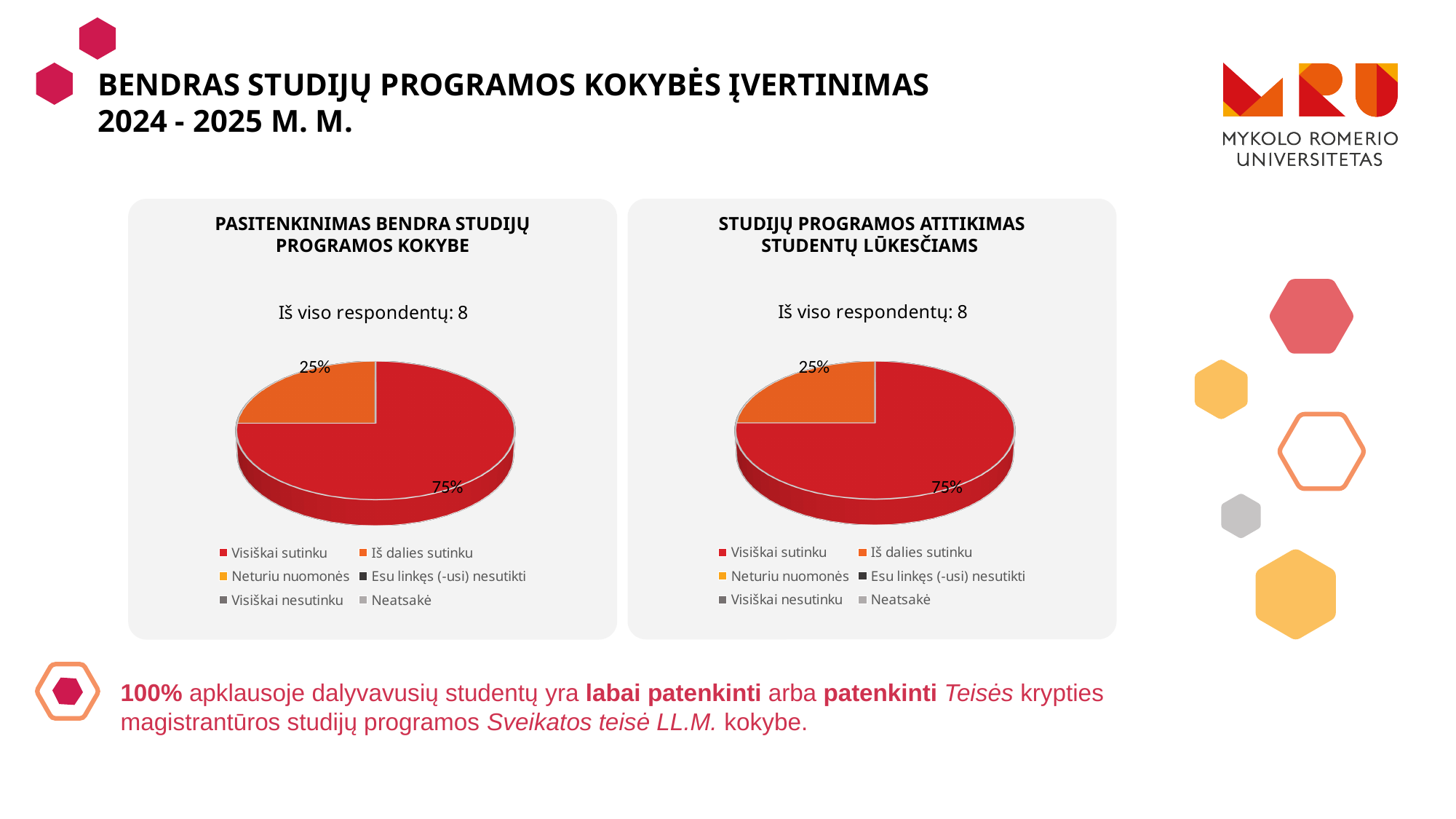
In the right chart 'Studijų programos atitikimas studentų lūkesčiams', what share of respondents answered 'Iš dalies sutinku'? 25% In the left chart 'Pasitenkinimas bendra studijų programos kokybe', which answer category has the largest slice? Visiškai sutinku In the left chart 'Pasitenkinimas bendra studijų programos kokybe', what share of respondents answered 'Visiškai sutinku'? 75% In the left chart 'Pasitenkinimas bendra studijų programos kokybe', what share of respondents answered 'Iš dalies sutinku'? 25% How many respondents in total are reported for the left chart 'Pasitenkinimas bendra studijų programos kokybe'? 8 In the right chart 'Studijų programos atitikimas studentų lūkesčiams', what share of respondents answered 'Visiškai sutinku'? 75% How many answer categories does the legend of the right chart 'Studijų programos atitikimas studentų lūkesčiams' list? 6 In the right chart 'Studijų programos atitikimas studentų lūkesčiams', which is larger: the 'Visiškai sutinku' slice or the 'Iš dalies sutinku' slice? Visiškai sutinku What type of chart is used in the left panel 'Pasitenkinimas bendra studijų programos kokybe'? Pie chart In the left chart 'Pasitenkinimas bendra studijų programos kokybe', what colour is the 'Iš dalies sutinku' slice? Orange In the left chart 'Pasitenkinimas bendra studijų programos kokybe', what is the difference in percentage points between the 'Visiškai sutinku' and 'Iš dalies sutinku' slices? 50 percentage points In the right chart 'Studijų programos atitikimas studentų lūkesčiams', which answer category has the smallest non-zero slice? Iš dalies sutinku